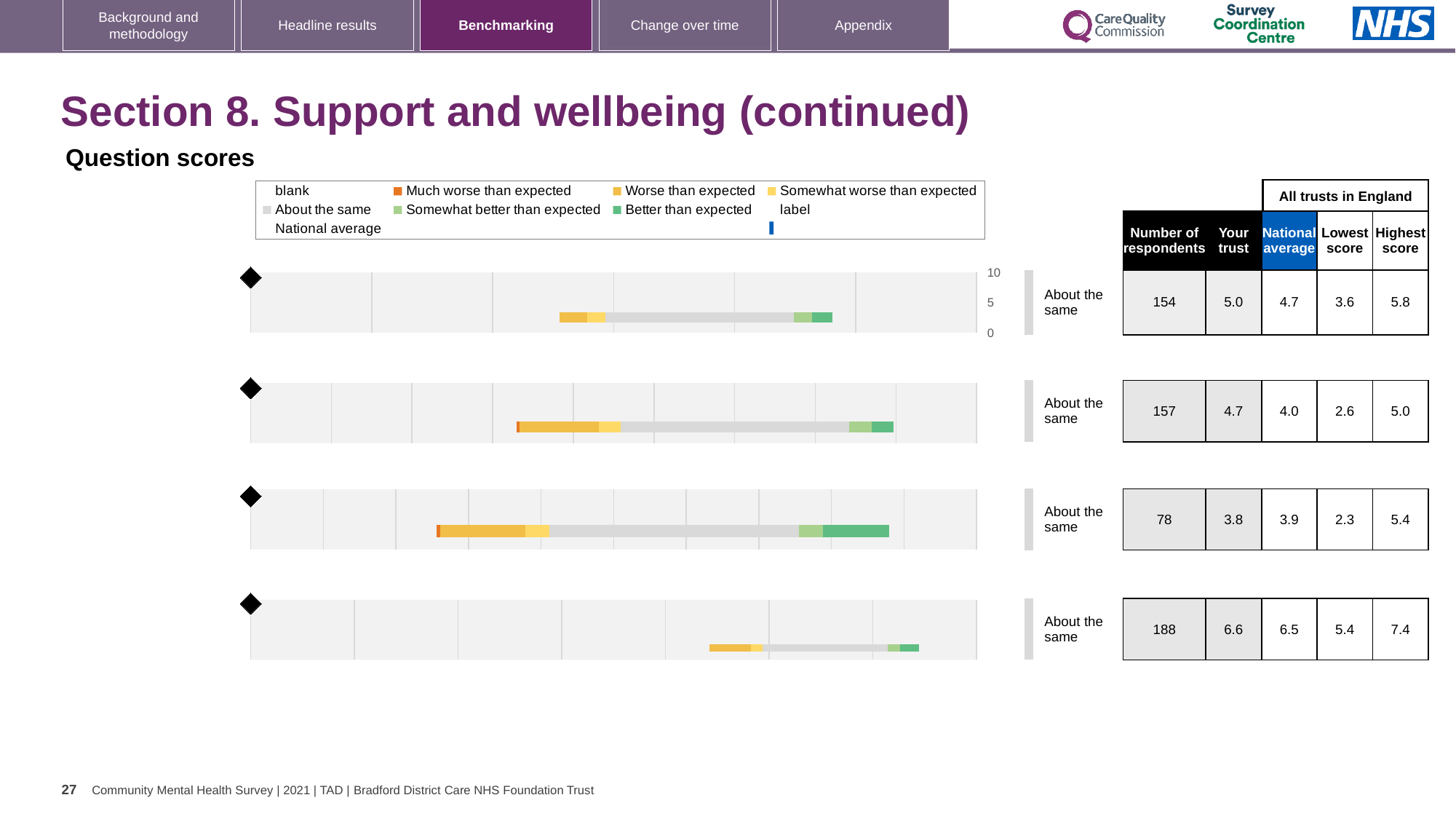
Which chart has the highest 'Your trust' score? The fourth (bottom) chart For the second chart, what is the lowest score among all trusts in England? 2.6 For the third chart, which is larger: the 'Your trust' score or the national average? National average For the fourth (bottom) chart, how much higher is the 'Your trust' score than the national average? 0.1 Which chart has the lowest number of respondents? The third chart How many question-score bar charts are shown on the slide? 4 For the second chart, what is the national average score? 4.0 For the first (top) chart, what is the 'Your trust' score shown in the table? 5.0 What kind of chart is used for the four question-score rows on the slide? bar chart For the first (top) chart, what is the difference between the highest score and the lowest score? 2.2 For the fourth (bottom) chart, what is the highest score among all trusts in England? 7.4 For the third chart, how many respondents are listed? 78